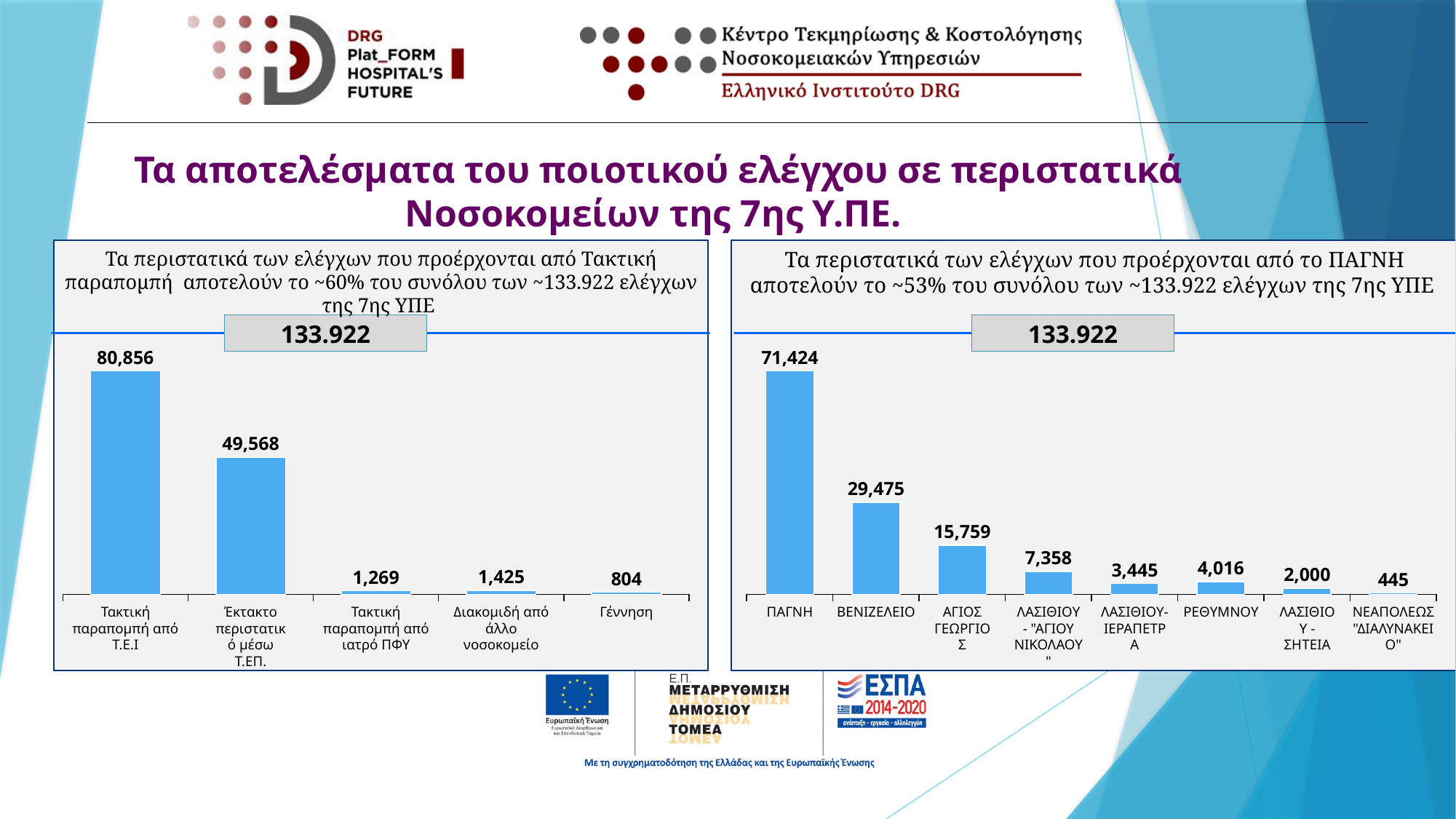
In the left chart, how many categories are shown? 5 In the right chart, which is larger: ΛΑΣΙΘΙΟΥ-ΙΕΡΑΠΕΤΡΑ or ΡΕΘΥΜΝΟΥ? ΡΕΘΥΜΝΟΥ In the right chart, what is the value for ΡΕΘΥΜΝΟΥ? 4,016 In the left chart, what is the difference between Τακτική παραπομπή από Τ.Ε.Ι and Έκτακτο περιστατικό μέσω Τ.ΕΠ.? 31,288 In the left chart, which category has the lowest value? Γέννηση In the left chart, what is the value for Γέννηση? 804 In the right chart, how many hospitals are shown? 8 In the left chart, which category has the highest value? Τακτική παραπομπή από Τ.Ε.Ι In the right chart, which hospital has the lowest value? ΝΕΑΠΟΛΕΩΣ "ΔΙΑΛΥΝΑΚΕΙΟ" What type of chart is the right chart? Bar chart In the right chart, what is the value for ΒΕΝΙΖΕΛΕΙΟ? 29,475 In the left chart, what is the value for Τακτική παραπομπή από Τ.Ε.Ι? 80,856